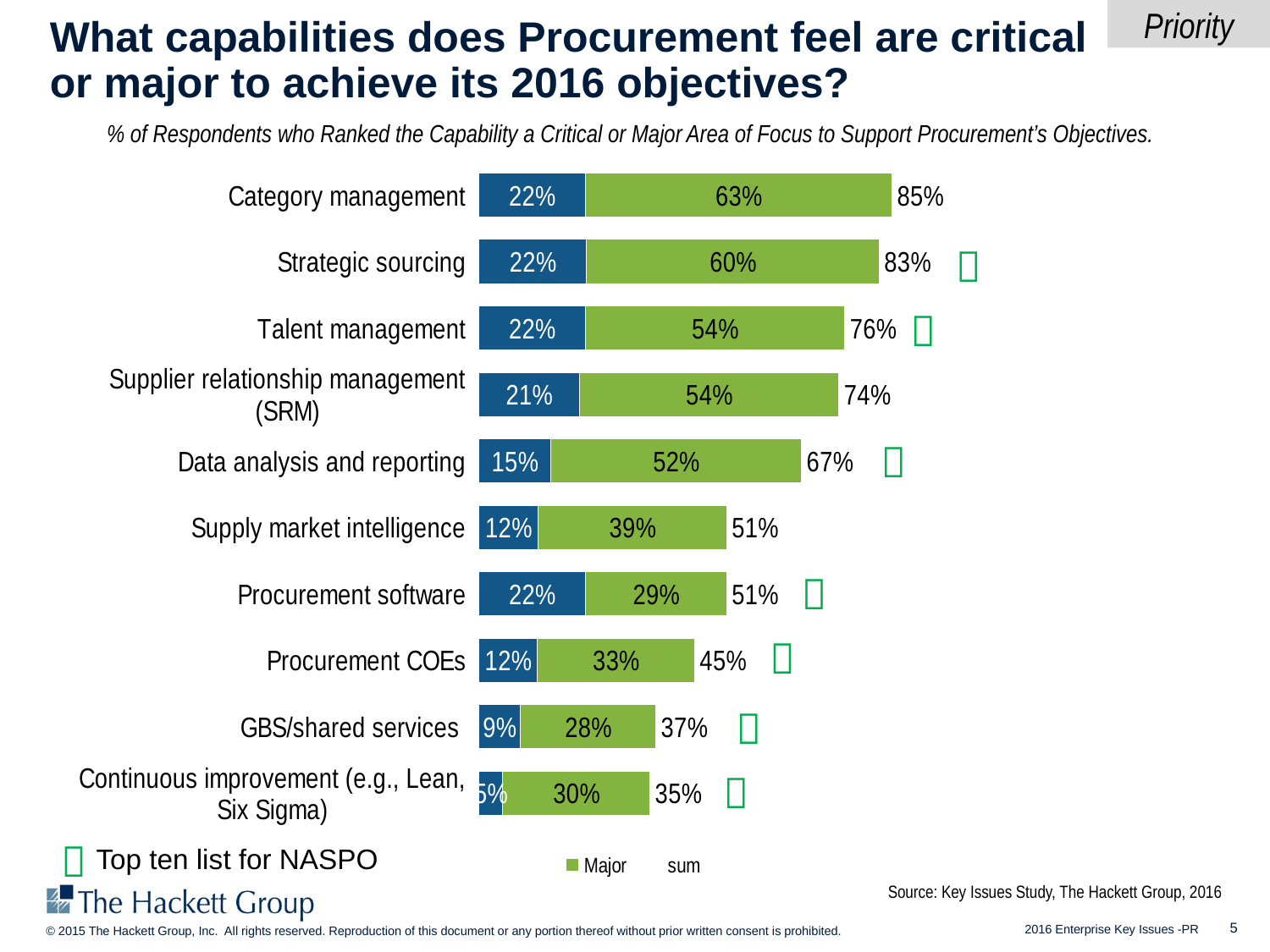
Which capability has the highest sum value? Category management How many capabilities are listed on the chart? 10 What is the Major percentage for GBS/shared services? 28% What is the value of the blue segment for Data analysis and reporting? 15% Which colour represents the Major series in the legend? green Which has a larger Major percentage, Supply market intelligence or Procurement COEs? Supply market intelligence For Procurement software, how much larger is the Major percentage than the blue segment percentage? 7 percentage points What is the sum value shown for Talent management? 76% What type of chart is shown on the slide? bar chart What is the difference between the sum values for Category management and Strategic sourcing? 2 percentage points Which capability has the lowest sum value? Continuous improvement (e.g., Lean, Six Sigma) What is the Major percentage for Category management? 63%